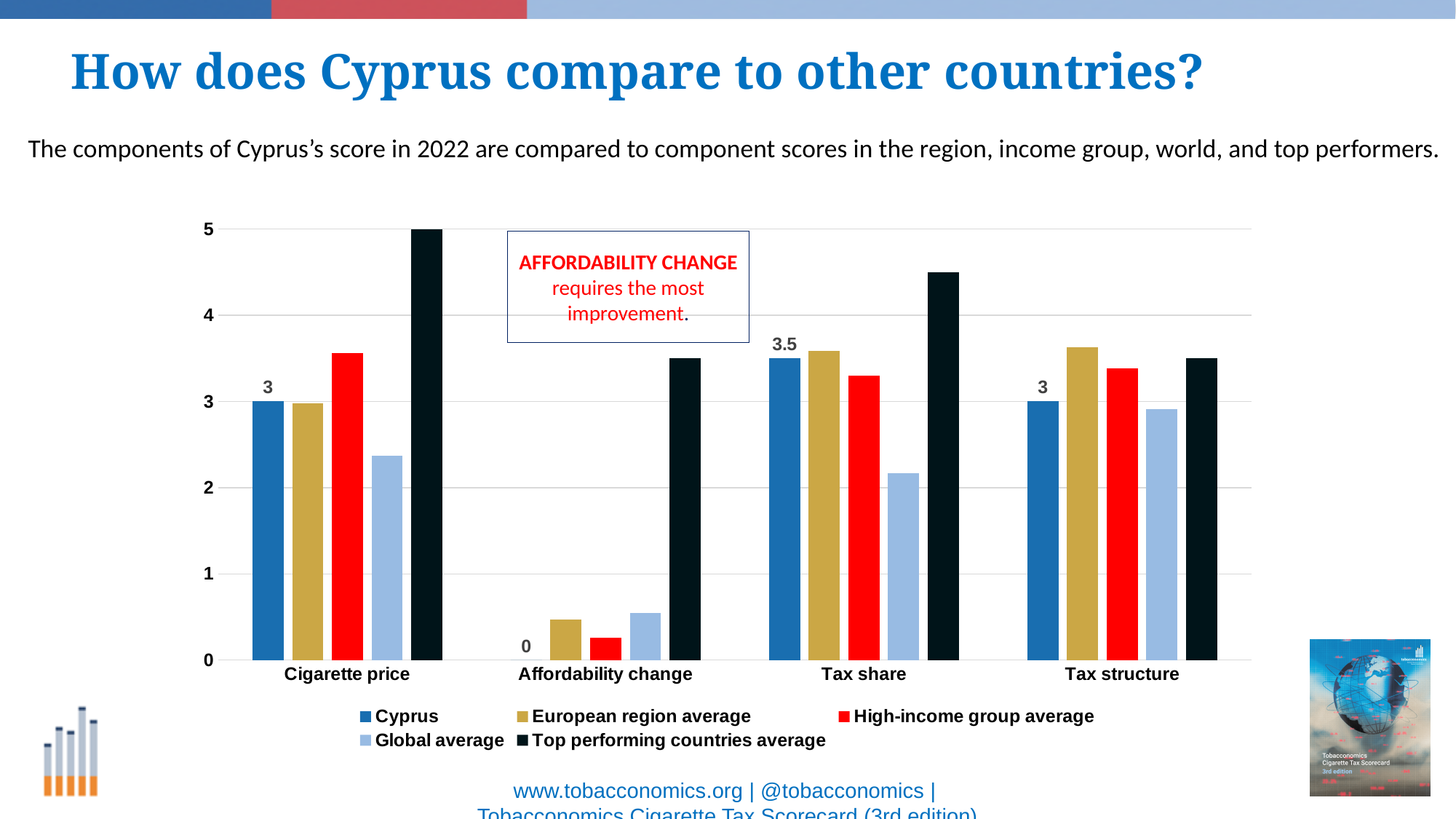
Which is larger: the Cyprus score for Tax share or the Cyprus score for Tax structure? Tax share Is the Global average for Cigarette price greater or less than 3? less How many series does the legend list? 5 What is the Cyprus score for Affordability change? 0 What is the Cyprus score for Tax share? 3.5 Which component has the highest Cyprus score? Tax share How many components are shown on the x axis of the chart? 4 Which component has the lowest Cyprus score? Affordability change What is the Cyprus score for Cigarette price? 3 What kind of chart is shown on the slide? Bar chart What is the difference between the Cyprus score for Tax share and the Cyprus score for Cigarette price? 0.5 Is the Top performing countries average for Tax share greater or less than 4? greater